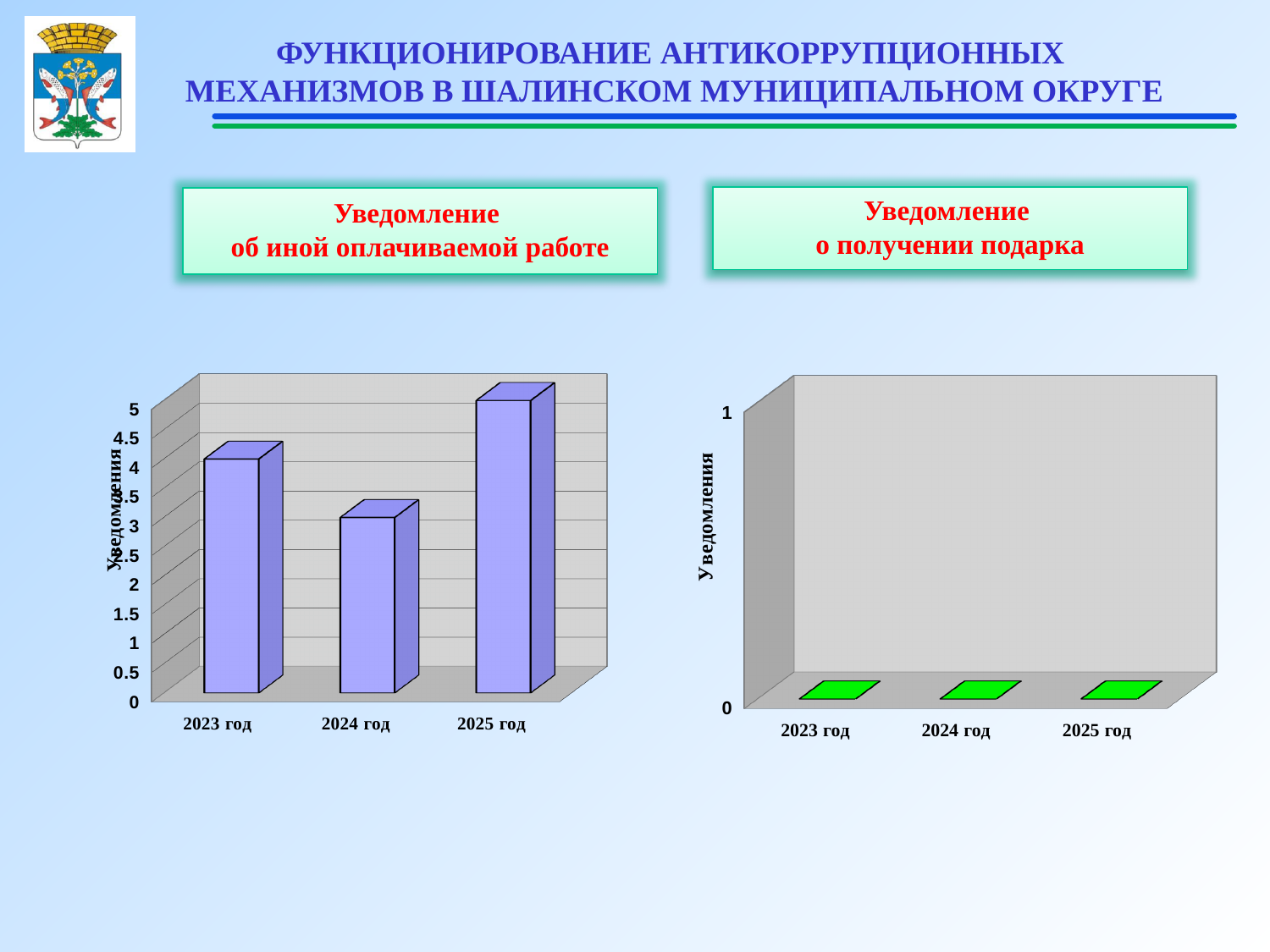
On the right chart (Уведомление о получении подарка), what is the value for 2024 год? 0 What kind of chart is the left chart (Уведомление об иной оплачиваемой работе)? bar chart On the left chart (Уведомление об иной оплачиваемой работе), how many years are shown on the x axis? 3 On the left chart (Уведомление об иной оплачиваемой работе), which year has the highest value? 2025 год On the left chart (Уведомление об иной оплачиваемой работе), what is the value for 2025 год? 5 On the left chart (Уведомление об иной оплачиваемой работе), what is the value for 2024 год? 3 What is the label of the vertical axis on the left chart (Уведомление об иной оплачиваемой работе)? Уведомления On the left chart (Уведомление об иной оплачиваемой работе), what is the difference between the values for 2025 год and 2024 год? 2 On the left chart (Уведомление об иной оплачиваемой работе), which is larger, the value for 2023 год or 2024 год? 2023 год On the left chart (Уведомление об иной оплачиваемой работе), which year has the lowest value? 2024 год On the right chart (Уведомление о получении подарка), what is the highest value shown on the vertical axis? 1 On the left chart (Уведомление об иной оплачиваемой работе), what is the value for 2023 год? 4